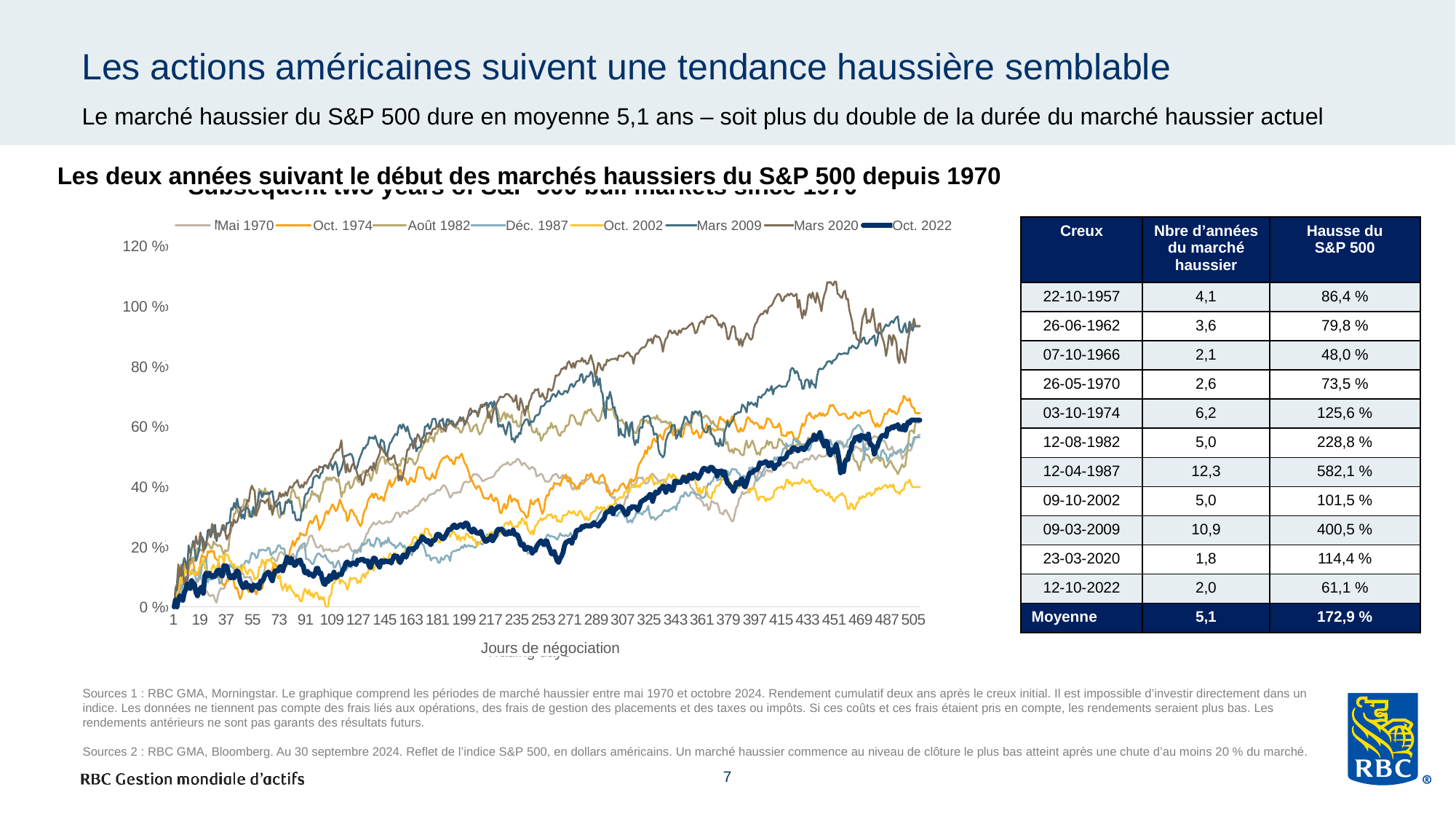
Is the value for the Oct. 2022 series at trading day 505 greater or less than 40 %? greater What is the label of the x axis of the chart? Jours de négociation Which series has the lowest value at trading day 505? Oct. 2002 Does the Oct. 2022 series generally rise or fall across the trading days shown? rise Is the value for the Mars 2020 series at its peak greater or less than 100 %? greater Which series is drawn with the thick dark blue line in the chart? Oct. 2022 Which series reaches the highest value anywhere on the chart? Mars 2020 Is the value for the Mars 2009 series at trading day 505 greater or less than 80 %? greater How many series does the chart legend list? 8 At trading day 505, is the value for Mars 2009 larger or smaller than the value for Oct. 2002? larger What kind of chart is shown on the slide? line chart